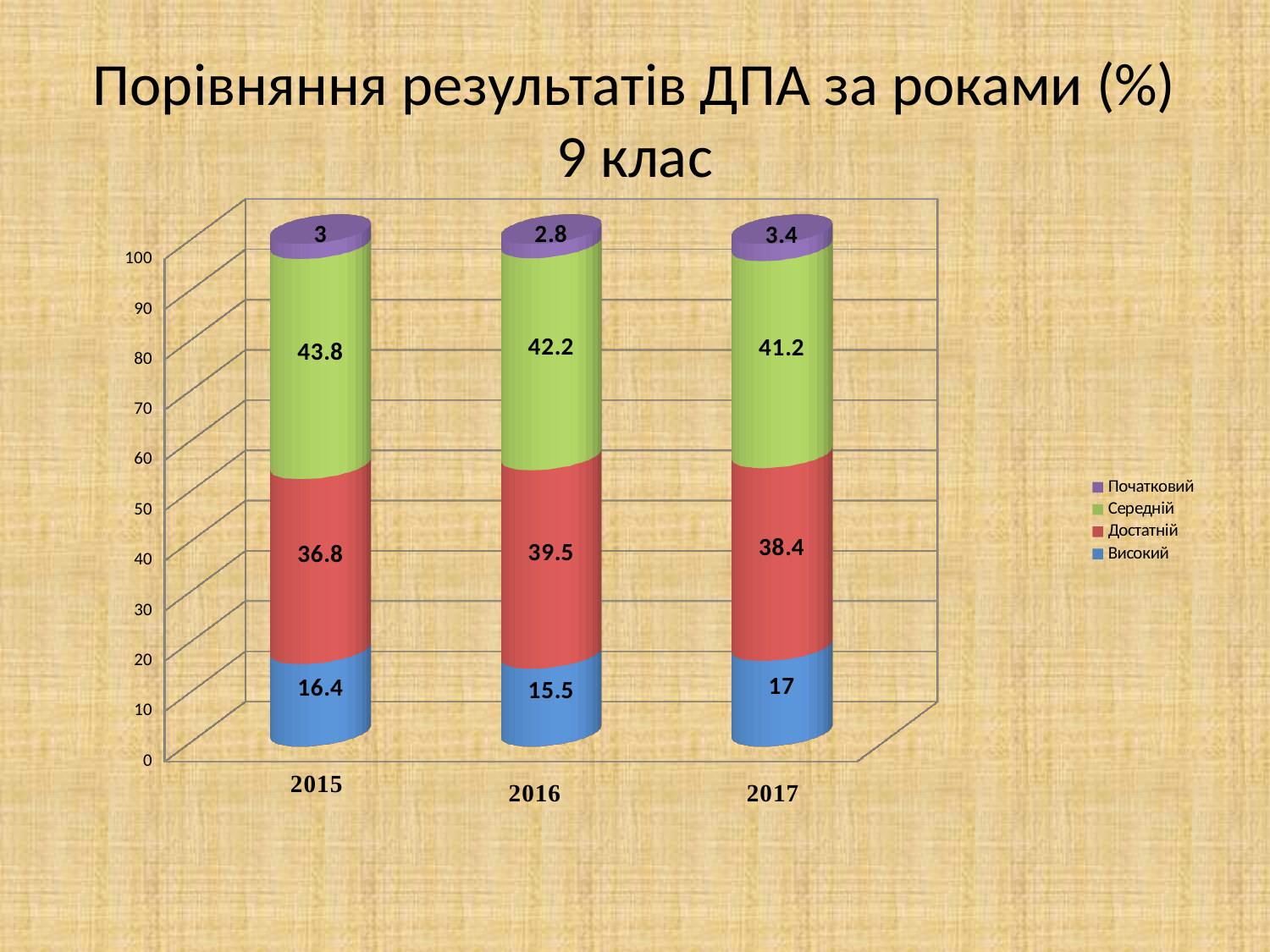
How many series does the legend list? 4 How many years are shown on the x axis? 3 What is the difference between the Достатній values for 2016 and 2015? 2.7 What kind of chart is shown on the slide? Stacked bar chart What is the value for Високий in 2016? 15.5 Which is larger, the Середній value for 2016 or for 2017? 2016 What is the value for Середній in 2015? 43.8 In which year is the Високий value highest? 2017 What is the total of the stacked bar for 2015? 100 What is the value for Достатній in 2016? 39.5 What is the value for Початковий in 2017? 3.4 In which year is the Початковий value lowest? 2016